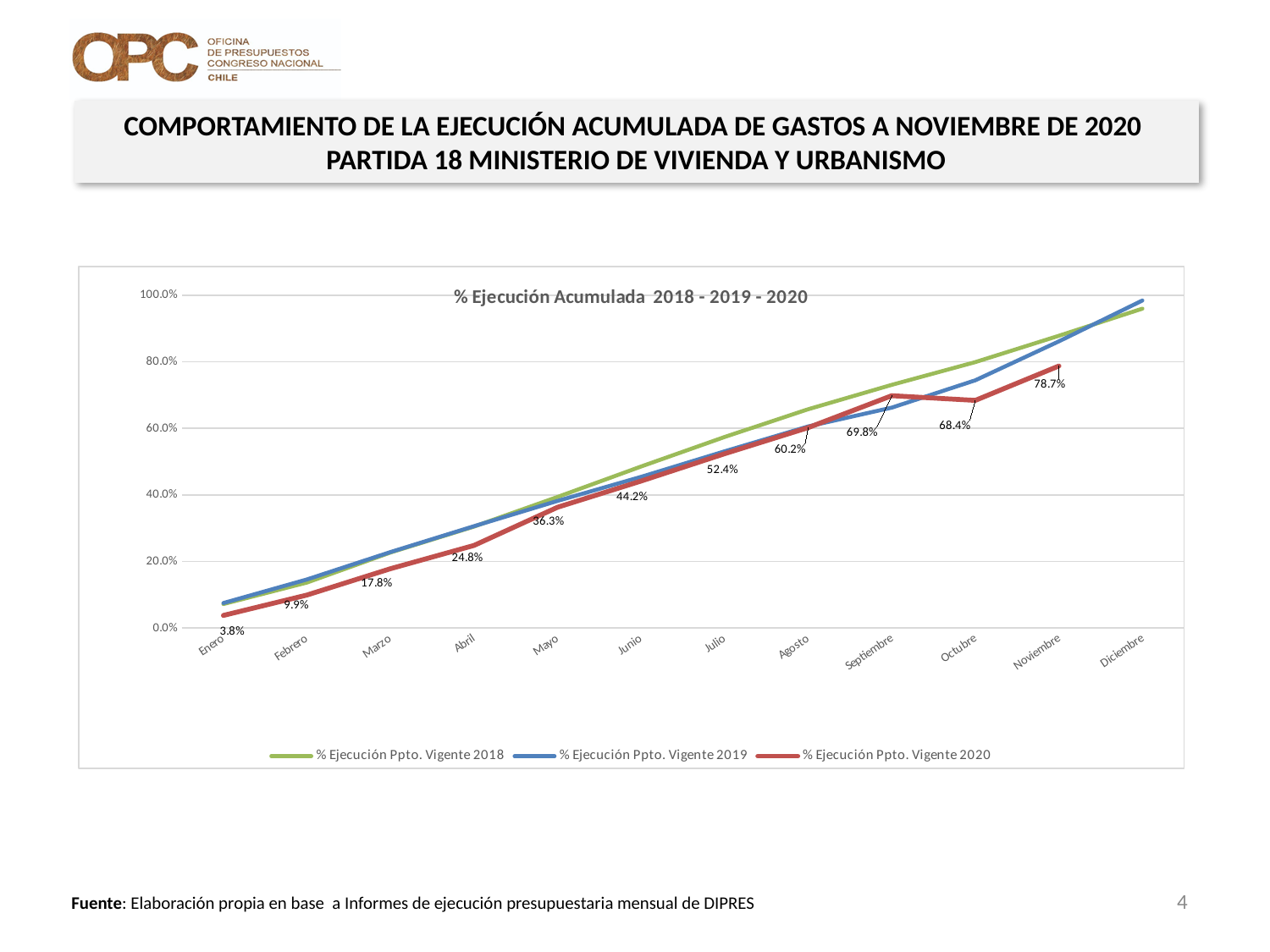
Which is larger for the 2020 series, Septiembre or Octubre? Septiembre What type of chart is shown on the slide? line chart Which month has the lowest value for the 2020 series? Enero What is the value of % Ejecución Ppto. Vigente 2020 for Noviembre? 78.7% How many months are shown on the x axis? 12 Does the 2020 series generally rise or fall from Enero to Agosto? rise What is the chart's title? % Ejecución Acumulada 2018 - 2019 - 2020 What is the value of % Ejecución Ppto. Vigente 2020 for Mayo? 36.3% How many series does the legend list? 3 What is the value of % Ejecución Ppto. Vigente 2020 for Enero? 3.8% What is the difference between the 2020 values for Noviembre and Octubre? 10.3% Is the value of % Ejecución Ppto. Vigente 2019 for Diciembre greater or less than 80.0%? greater